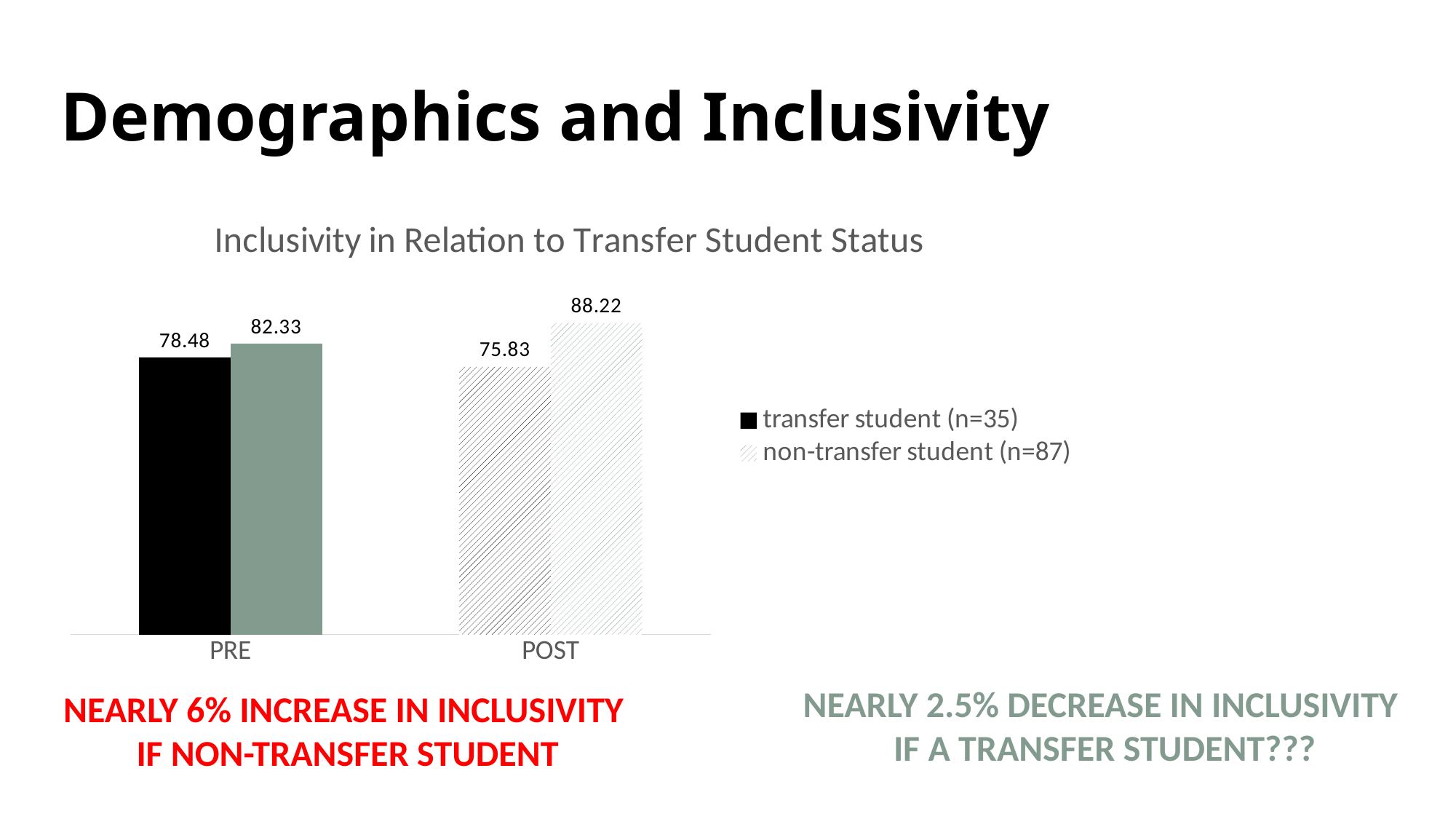
What is the value for non-transfer students in the POST category? 88.22 What is the value for transfer students in the POST category? 75.83 Which bar has the highest value in the chart? non-transfer student, POST What is the difference between the non-transfer student and transfer student values in the POST category? 12.39 What is the value for transfer students in the PRE category? 78.48 How many categories are shown on the x axis? 2 How many series does the legend list? 2 What type of chart is shown on the slide? bar chart Which bar has the lowest value in the chart? transfer student, POST What is the difference between the non-transfer student values for POST and PRE? 5.89 Which is larger: the transfer student value for PRE or for POST? PRE What is the value for non-transfer students in the PRE category? 82.33